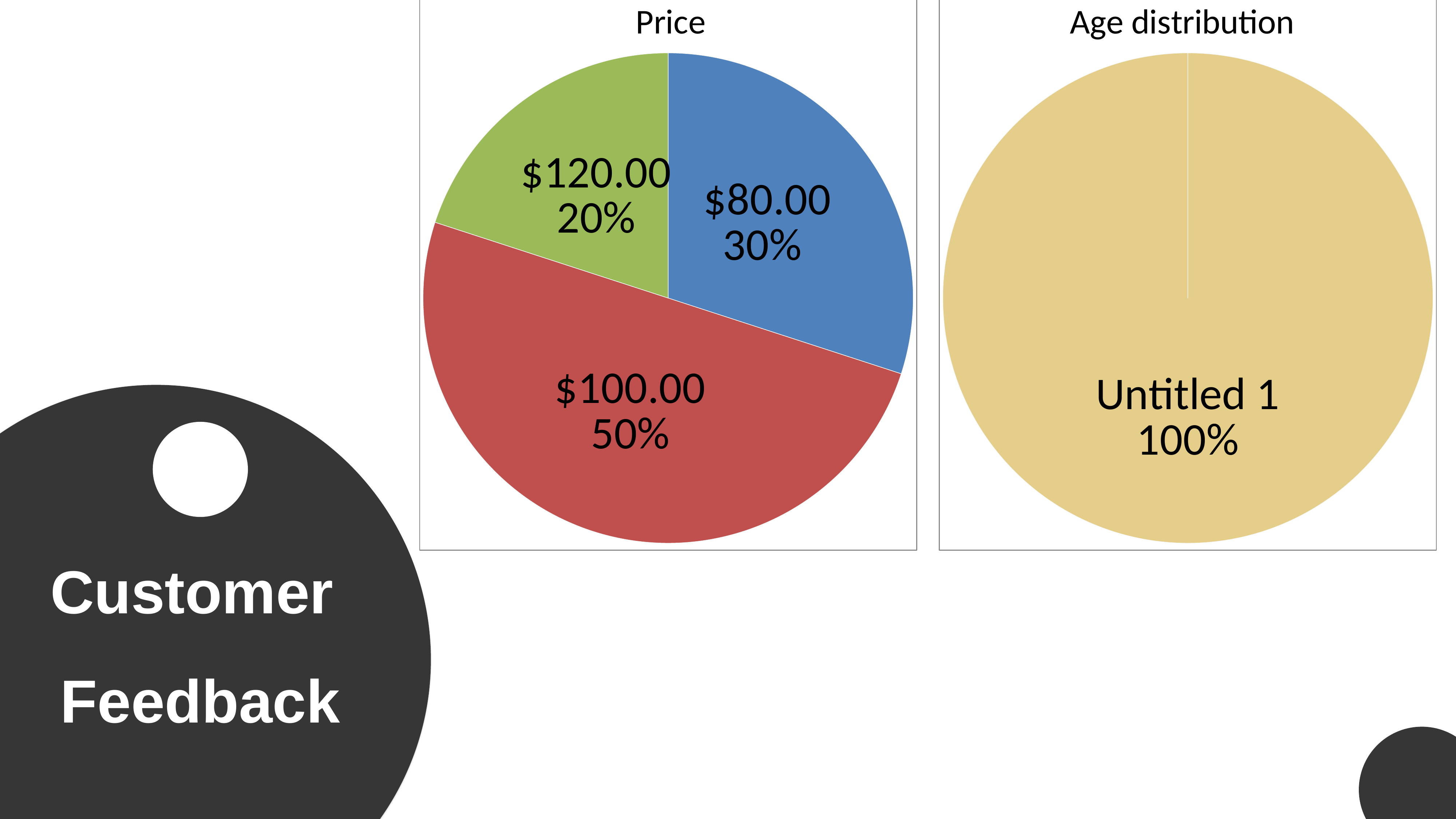
In the "Price" chart, which slice has the smallest share of the pie? $120.00 What kind of chart is the "Price" chart? pie chart In the "Price" chart, what share of the pie does the $80.00 slice represent? 30% In the "Price" chart, what share of the pie does the $120.00 slice represent? 20% In the "Price" chart, which slice has a larger share: the $80.00 slice or the $120.00 slice? $80.00 In the "Price" chart, how many slices does the pie have? 3 In the "Age distribution" chart, what share of the pie does the "Untitled 1" slice represent? 100% In the "Price" chart, what colour is the slice labelled $100.00? red In the "Price" chart, which slice has the largest share of the pie? $100.00 In the "Age distribution" chart, how many slices does the pie have? 1 What kind of chart is the "Age distribution" chart? pie chart